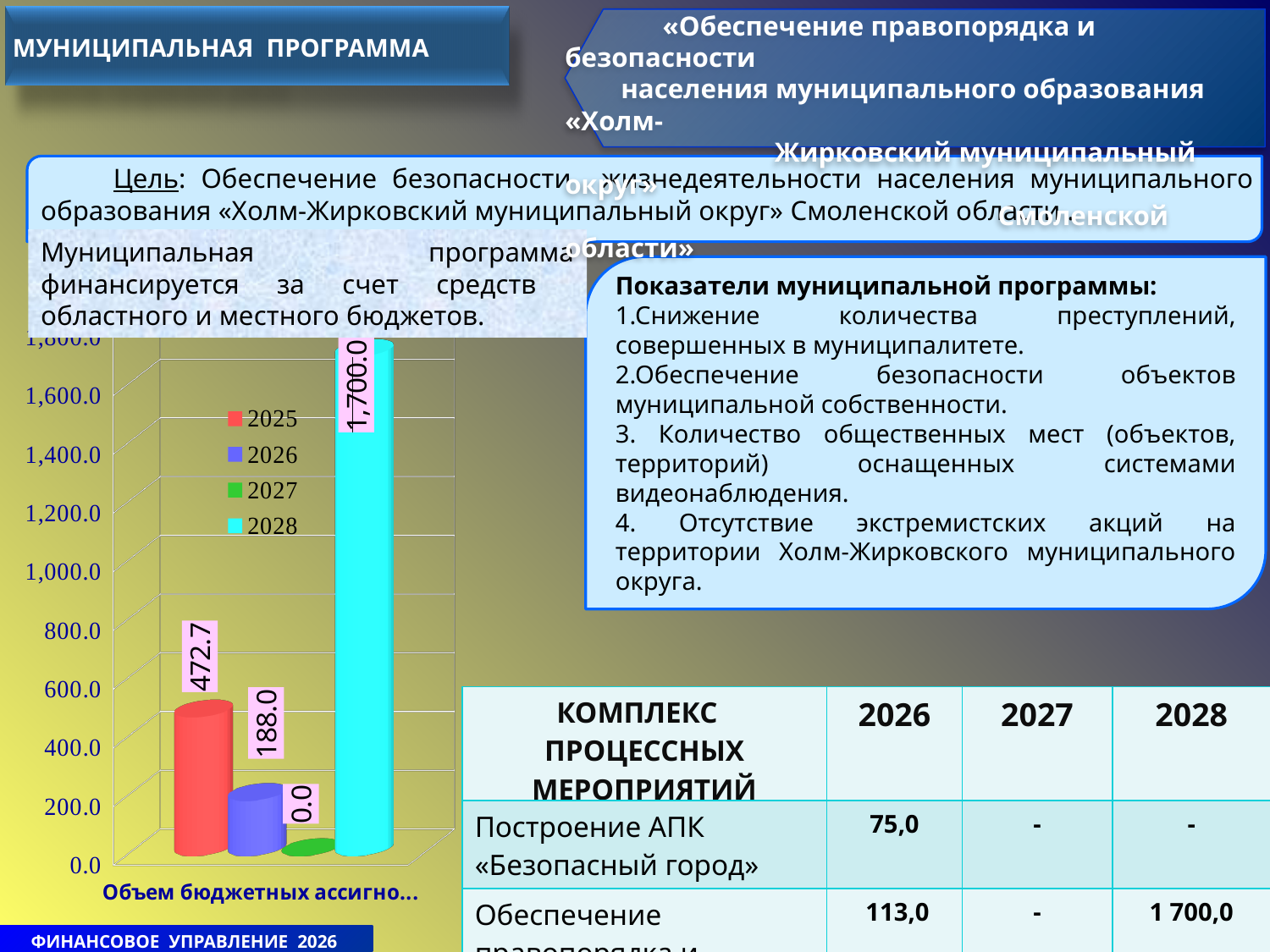
What kind of chart is shown on the slide? bar chart What is the difference between the 2025 value and the 2026 value in the chart? 284.7 Which series has the lowest value in the chart? 2027 What is the value of the 2026 bar in the chart? 188.0 How many series does the chart legend list? 4 What is the value of the 2028 bar in the chart? 1,700.0 What is the value of the 2025 bar in the chart? 472.7 What is the difference between the 2028 value and the 2025 value in the chart? 1,227.3 Which is larger in the chart, the 2025 value or the 2026 value? 2025 What colour is the 2028 series in the chart? cyan What is the value of the 2027 bar in the chart? 0.0 Which series has the highest value in the chart? 2028